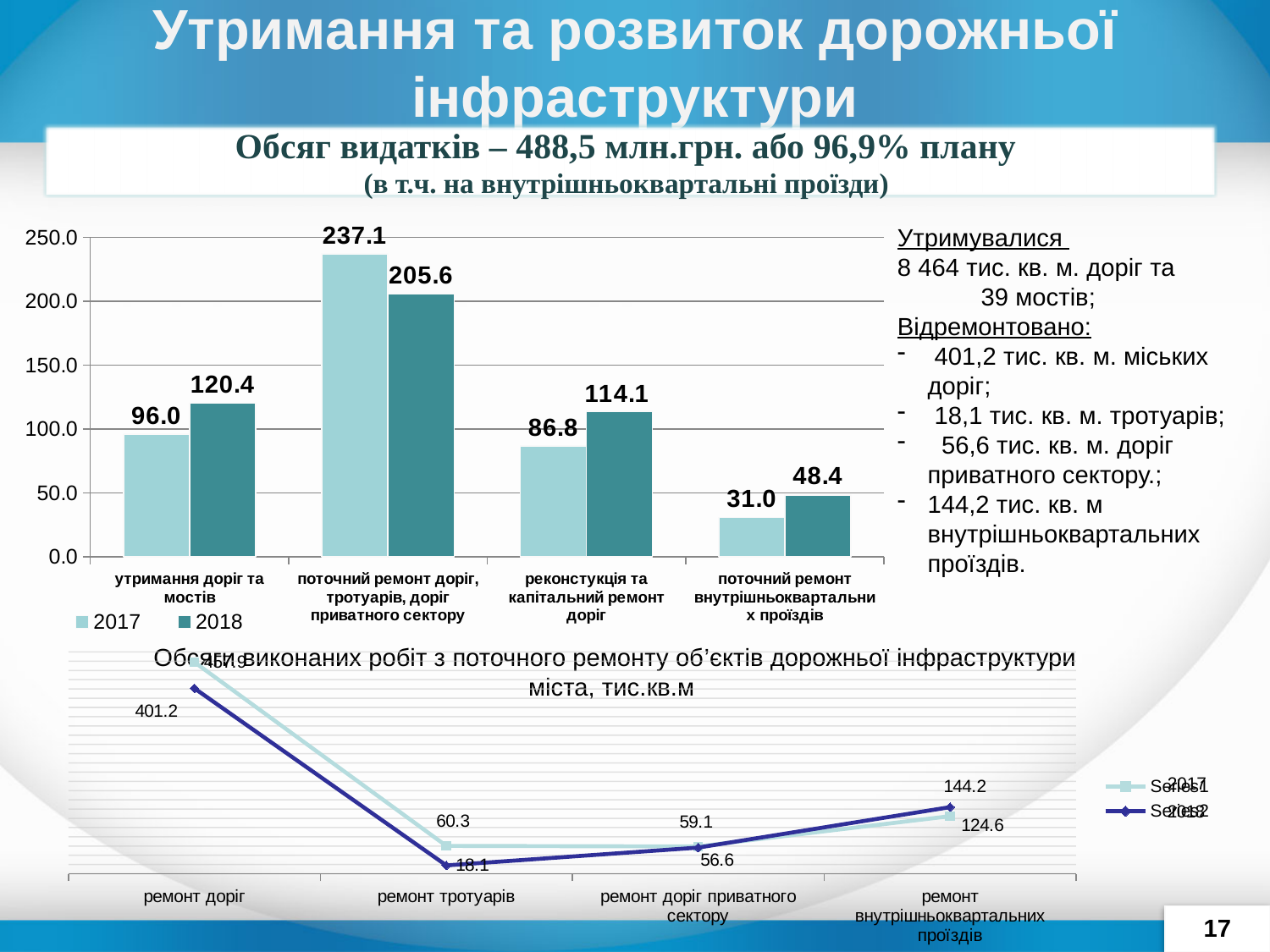
In the bottom line chart, what value is labelled on the dark blue line for ремонт тротуарів? 18.1 In the top bar chart, which is larger for утримання доріг та мостів: the 2017 value or the 2018 value? 2018 What kind of chart is the bottom chart on the slide? line chart How many categories are shown on the x axis of the top bar chart? 4 In the top bar chart, is the 2018 value for поточний ремонт внутрішньоквартальних проїздів greater or less than 50.0? less In the top bar chart, what is the 2017 value for поточний ремонт доріг, тротуарів, доріг приватного сектору? 237.1 In the top bar chart, what is the difference between the 2018 and 2017 values for реконстукція та капітальний ремонт доріг? 27.3 In the top bar chart, which category has the lowest 2017 value? поточний ремонт внутрішньоквартальних проїздів In the top bar chart, which category has the highest 2018 value? поточний ремонт доріг, тротуарів, доріг приватного сектору What kind of chart is the top chart on the slide? bar chart How many series does the legend of the top bar chart list? 2 In the top bar chart, what is the 2018 value for утримання доріг та мостів? 120.4